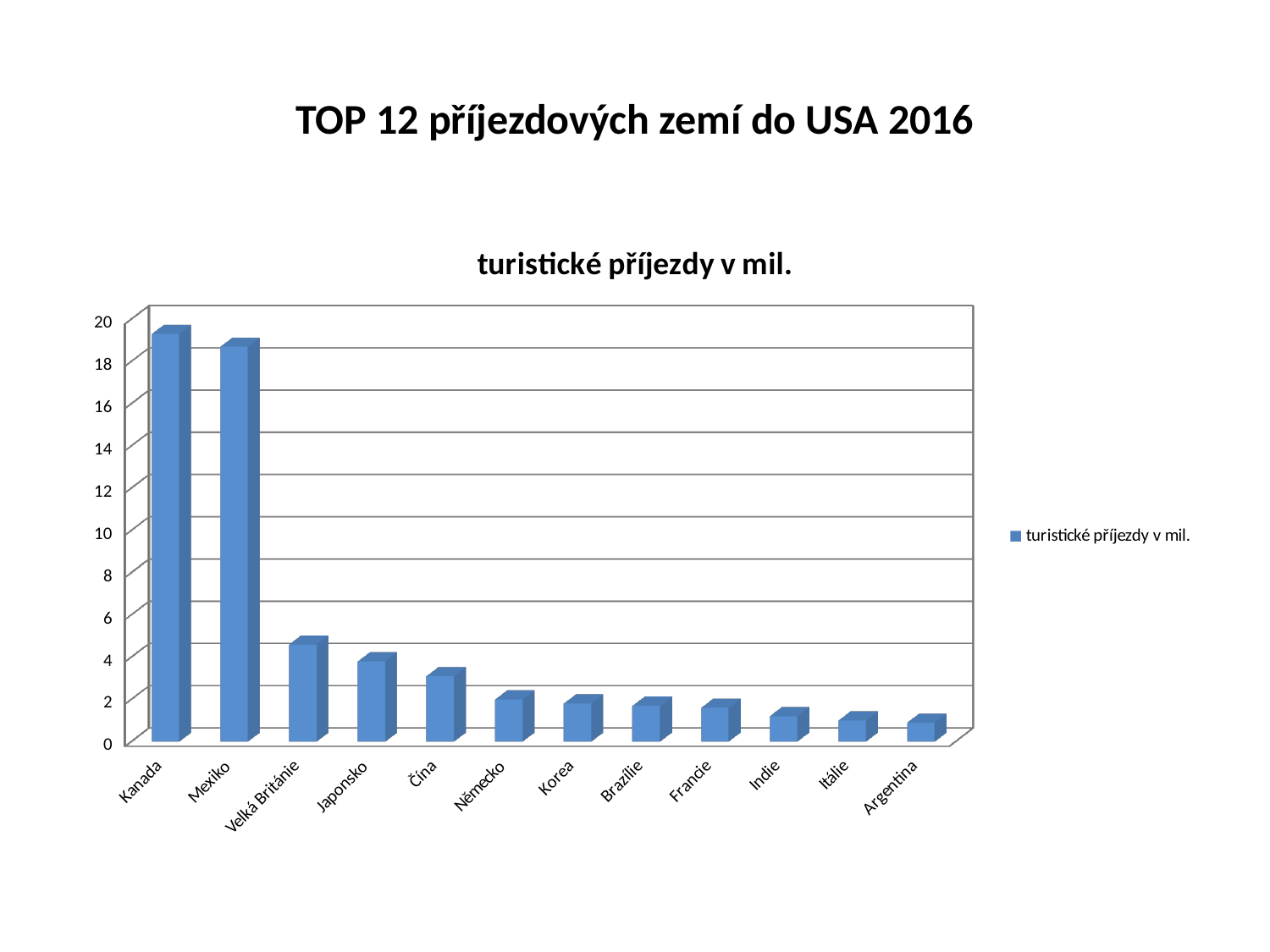
How many series does the legend list? 1 Is the value for Velká Británie greater or less than 4? greater How many countries are shown on the x axis of the chart? 12 Do the values rise or fall from left to right along the x axis? fall What kind of chart is shown on the slide? bar chart Which country has the highest value in the chart? Kanada Is the value for Kanada greater or less than 18? greater What is the title of the chart? turistické příjezdy v mil. Which has the larger value, Velká Británie or Japonsko? Velká Británie Is the value for Indie greater or less than 2? less